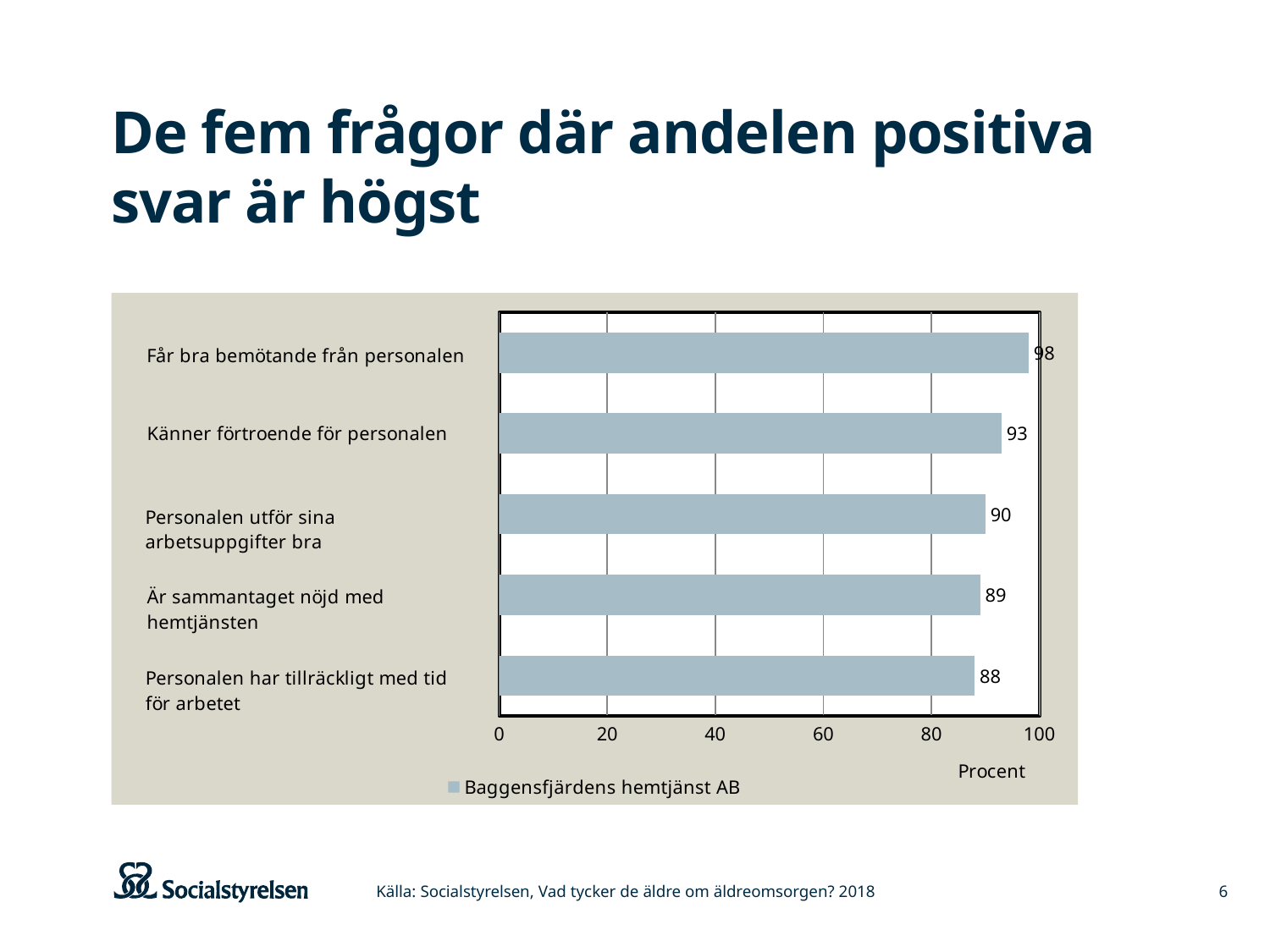
What kind of chart is shown on the slide? bar chart What series name does the legend show? Baggensfjärdens hemtjänst AB What is the value for "Personalen utför sina arbetsuppgifter bra"? 90 What is the difference between the values for "Får bra bemötande från personalen" and "Känner förtroende för personalen"? 5 How many categories are shown in the chart? 5 What is the value for "Personalen har tillräckligt med tid för arbetet"? 88 Which category has the highest value? Får bra bemötande från personalen What is the value for "Får bra bemötande från personalen"? 98 Is the value for "Känner förtroende för personalen" greater or less than 80? greater Which is larger: the value for "Är sammantaget nöjd med hemtjänsten" or the value for "Personalen har tillräckligt med tid för arbetet"? Är sammantaget nöjd med hemtjänsten Which category has the lowest value? Personalen har tillräckligt med tid för arbetet What is the value for "Känner förtroende för personalen"? 93